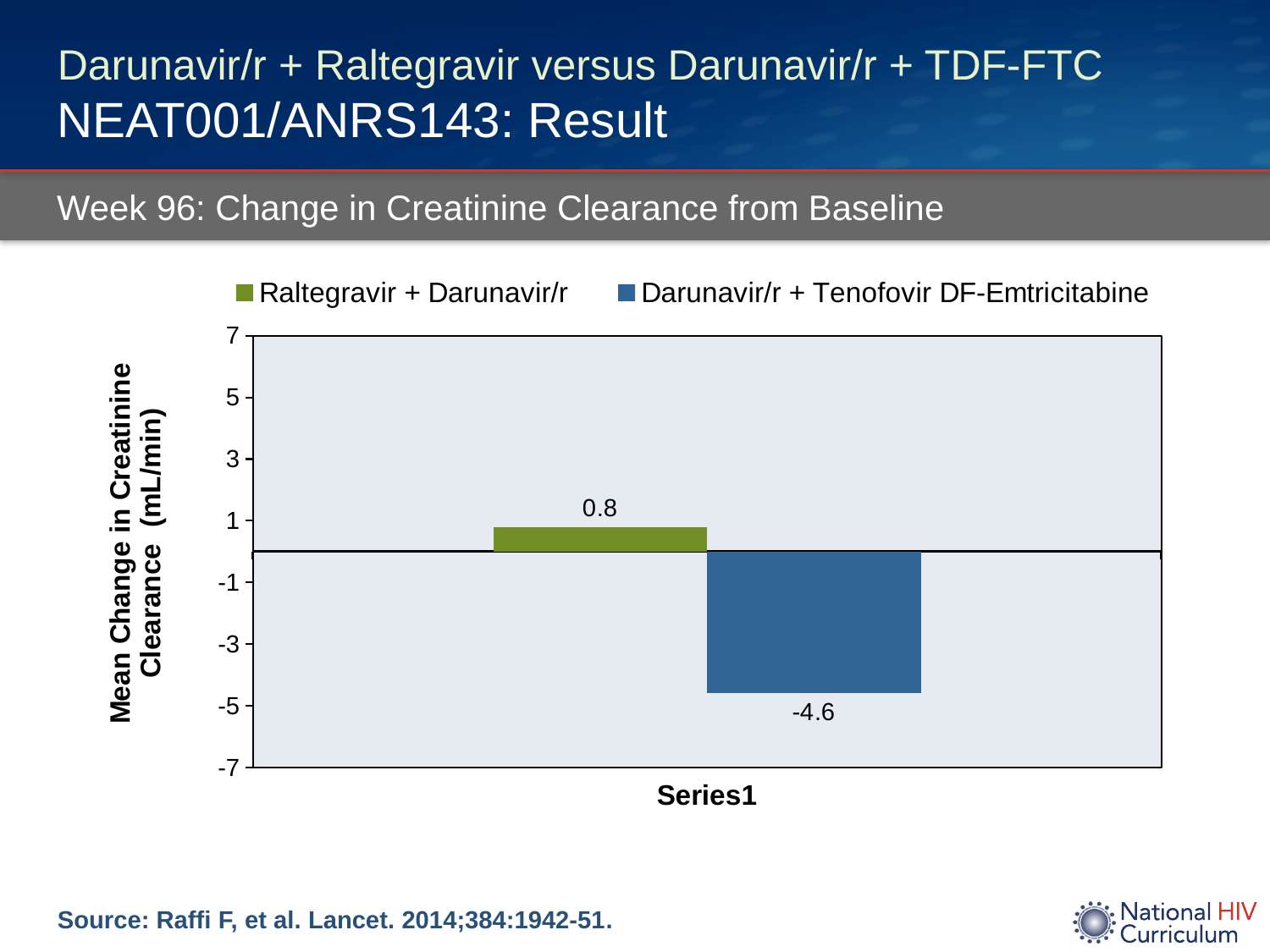
What is the label of the y axis? Mean Change in Creatinine Clearance (mL/min) What is the difference between the mean change for Raltegravir + Darunavir/r and for Darunavir/r + Tenofovir DF-Emtricitabine? 5.4 How many series does the legend list? 2 Is the value for Raltegravir + Darunavir/r greater or less than 1? less Is the value for Darunavir/r + Tenofovir DF-Emtricitabine greater or less than -3? less Which series has the higher mean change in creatinine clearance? Raltegravir + Darunavir/r Is the value for Raltegravir + Darunavir/r larger or smaller than the value for Darunavir/r + Tenofovir DF-Emtricitabine? larger What colour is the bar for Darunavir/r + Tenofovir DF-Emtricitabine? blue What kind of chart is shown on the slide? bar chart What is the mean change in creatinine clearance for Raltegravir + Darunavir/r? 0.8 What is the mean change in creatinine clearance for Darunavir/r + Tenofovir DF-Emtricitabine? -4.6 Which series has the lowest mean change in creatinine clearance? Darunavir/r + Tenofovir DF-Emtricitabine